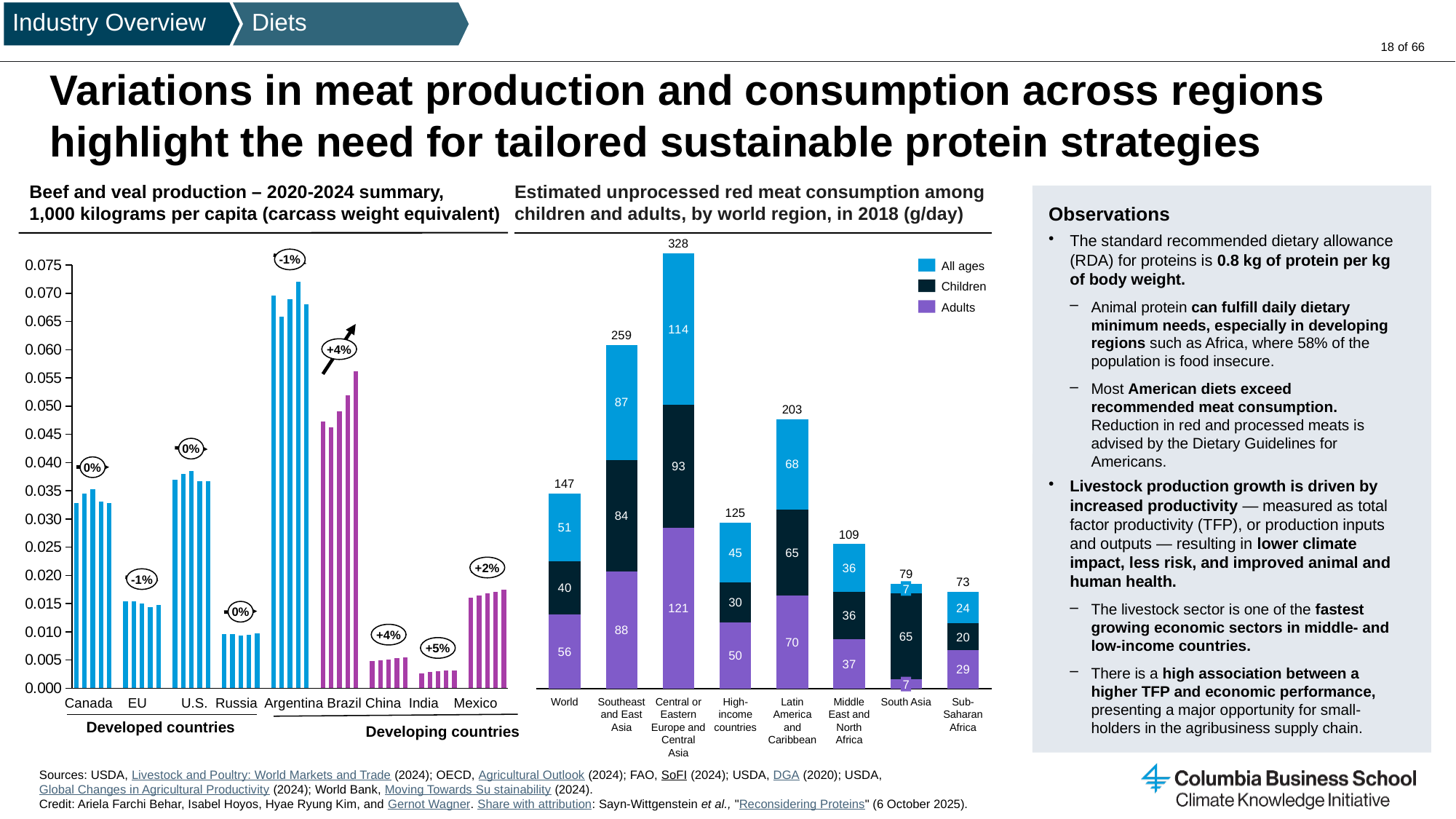
In the chart on the right, what is the Children value for South Asia? 65 What kind of chart is the chart on the left (beef and veal production)? bar chart In the chart on the right, which world region has the lowest total red meat consumption? Sub-Saharan Africa In the chart on the right (red meat consumption by world region), what is the total value shown for Central or Eastern Europe and Central Asia? 328 In the chart on the right, which is larger: the All ages value for World or the All ages value for High-income countries? World In the chart on the left, what growth percentage is annotated for Brazil? +4% In the chart on the left (beef and veal production), is the value for Argentina greater or less than 0.065? greater How many world regions are shown in the chart on the right? 8 In the chart on the right, which world region has the highest total red meat consumption? Central or Eastern Europe and Central Asia In the chart on the right, what is the difference between the total for Latin America and Caribbean and the total for High-income countries? 78 How many series does the legend of the chart on the right list? 3 In the chart on the right, what is the Adults value for Southeast and East Asia? 88